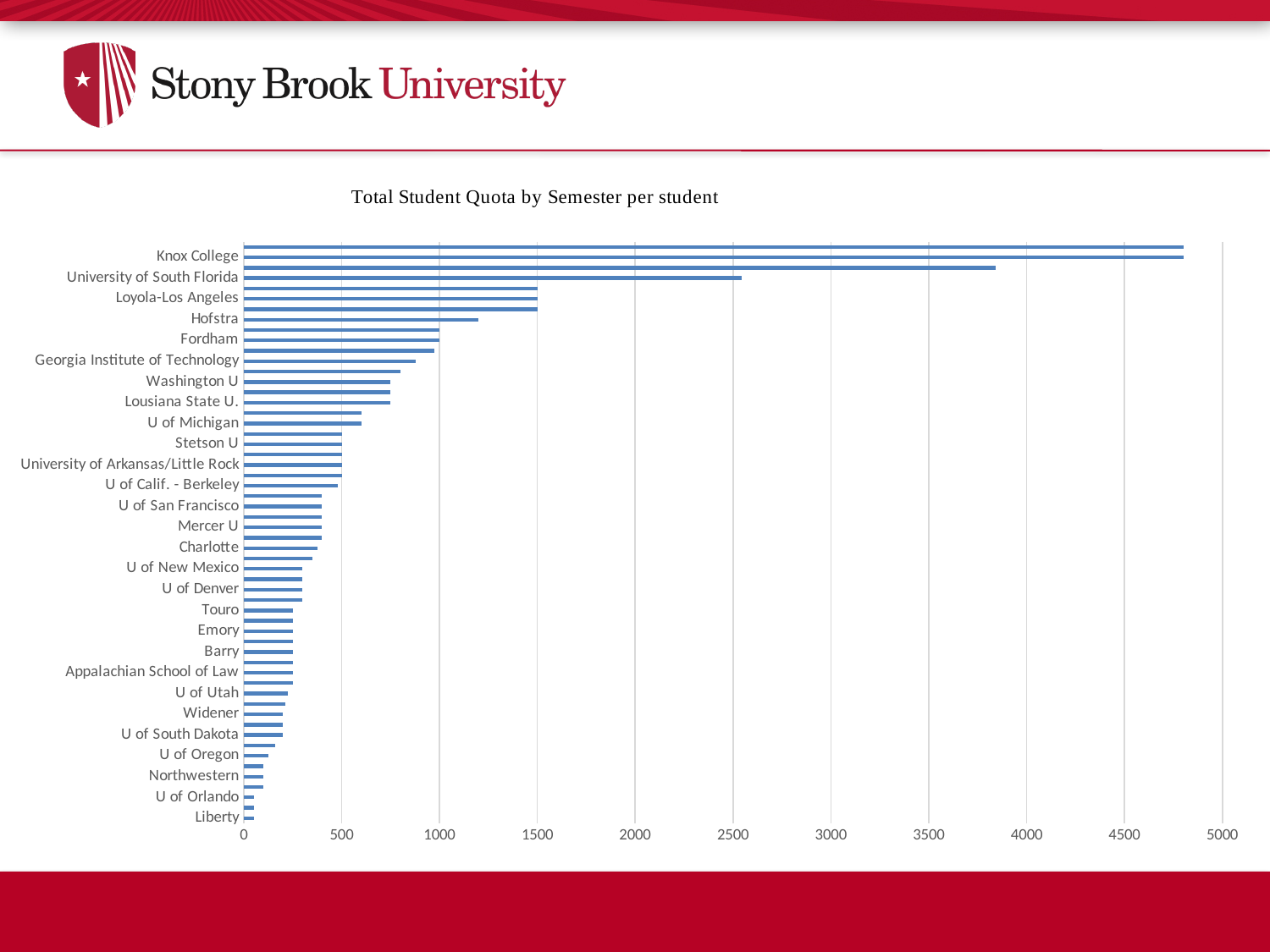
Is the value for Knox College greater or less than 4500? greater Is the value for University of South Florida greater or less than 2000? greater What is the title of the chart? Total Student Quota by Semester per student Which has a larger value, Fordham or Liberty? Fordham Which labeled institution has the highest value in the chart? Knox College What kind of chart is shown on the slide? bar chart Which has a larger value, Knox College or Hofstra? Knox College Is the value for Northwestern greater or less than 500? less Do the bar values increase or decrease going from the top of the chart to the bottom? decrease